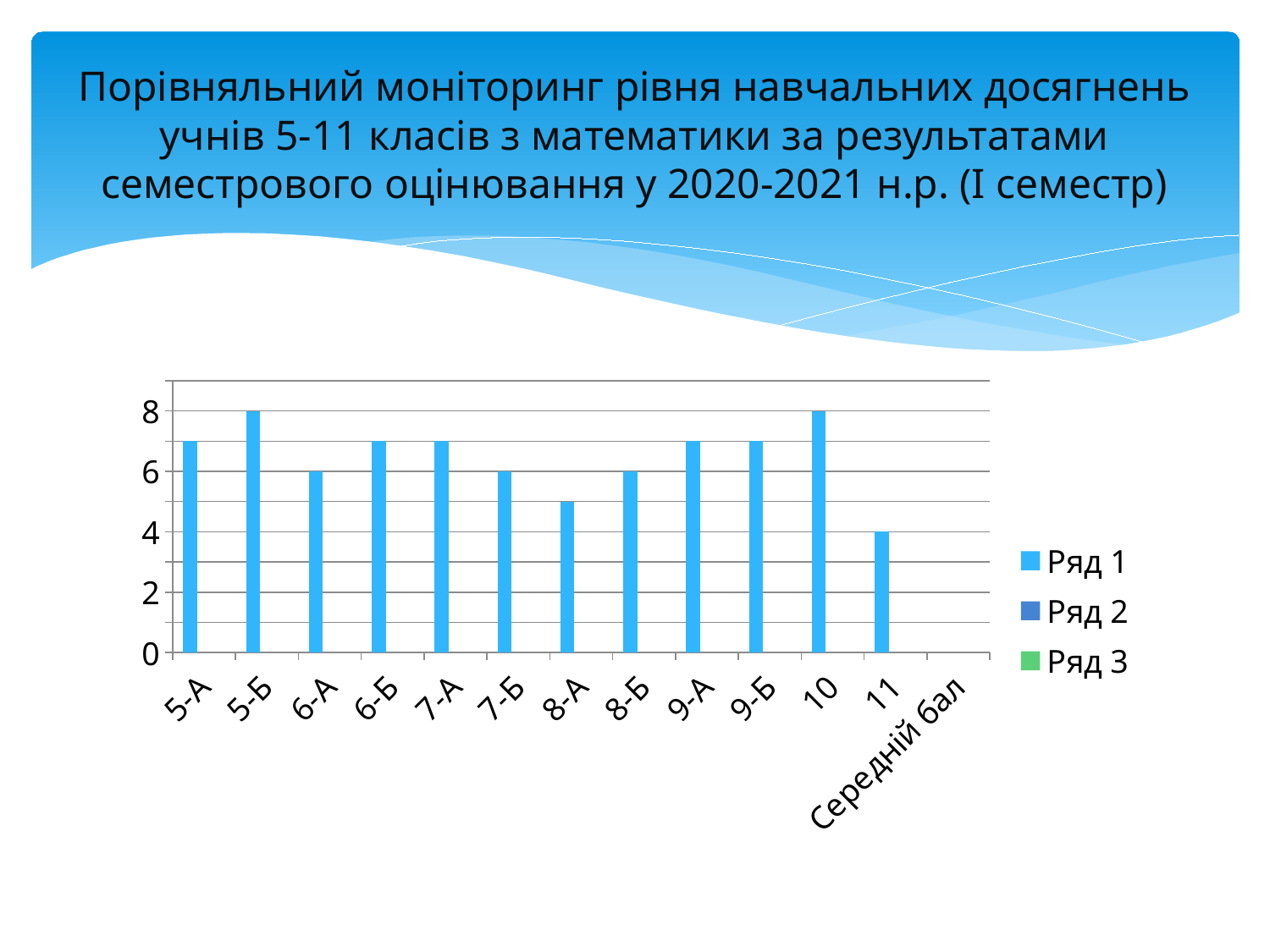
What is the value for 11? 4 What is the difference between the values for 5-Б and 11? 4 What kind of chart is shown on the slide? bar chart What is the value for 10? 8 What is the value for 5-Б? 8 What is the value for 6-А? 6 How many series does the legend list? 3 Which is larger, the value for 8-Б or the value for 11? 8-Б Is the value for 8-А greater or less than 6? less Is the value for 5-А greater or less than 6? greater How many categories are labelled on the x axis? 13 Which category has the lowest value? 11